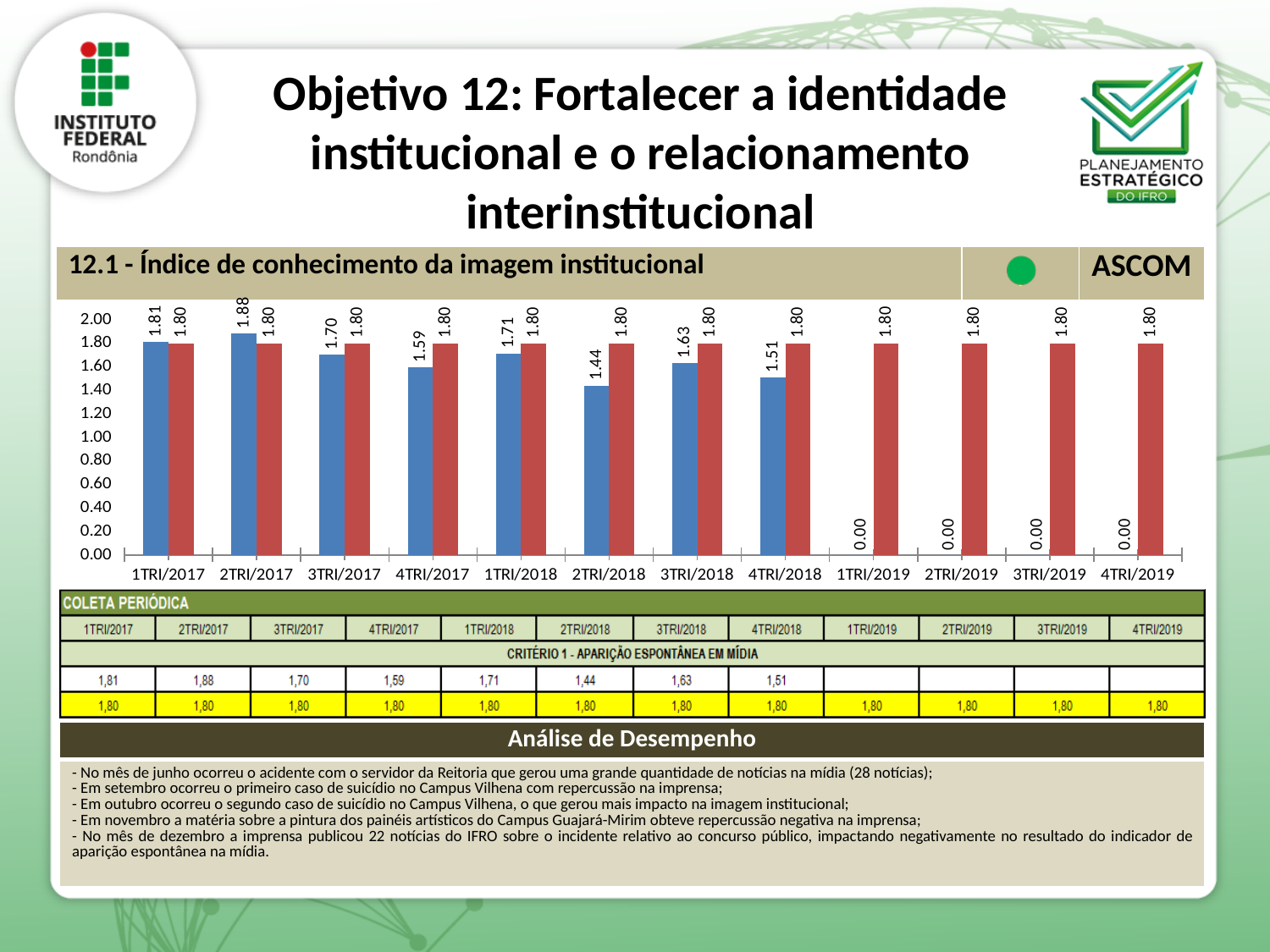
What is the value of the blue bar for 2TRI/2017? 1.88 How many quarters are shown on the x axis of the chart? 12 What is the value of the blue bar for 2TRI/2018? 1.44 What is the difference between the blue bar values for 2TRI/2017 and 2TRI/2018? 0.44 Among the quarters from 1TRI/2017 to 4TRI/2018, which quarter has the lowest blue bar value? 2TRI/2018 Which is larger, the blue bar for 1TRI/2017 or the blue bar for 3TRI/2018? 1TRI/2017 Among the quarters with non-zero blue bars, which quarter has the highest blue bar value? 2TRI/2017 What is the value of the red bar for 4TRI/2019? 1.80 What is the title of the indicator shown above the chart? 12.1 - Índice de conhecimento da imagem institucional What is the value of the blue bar for 4TRI/2017? 1.59 What kind of chart is shown on the slide? bar chart Is the blue bar value for 4TRI/2018 greater or less than 1.60? less